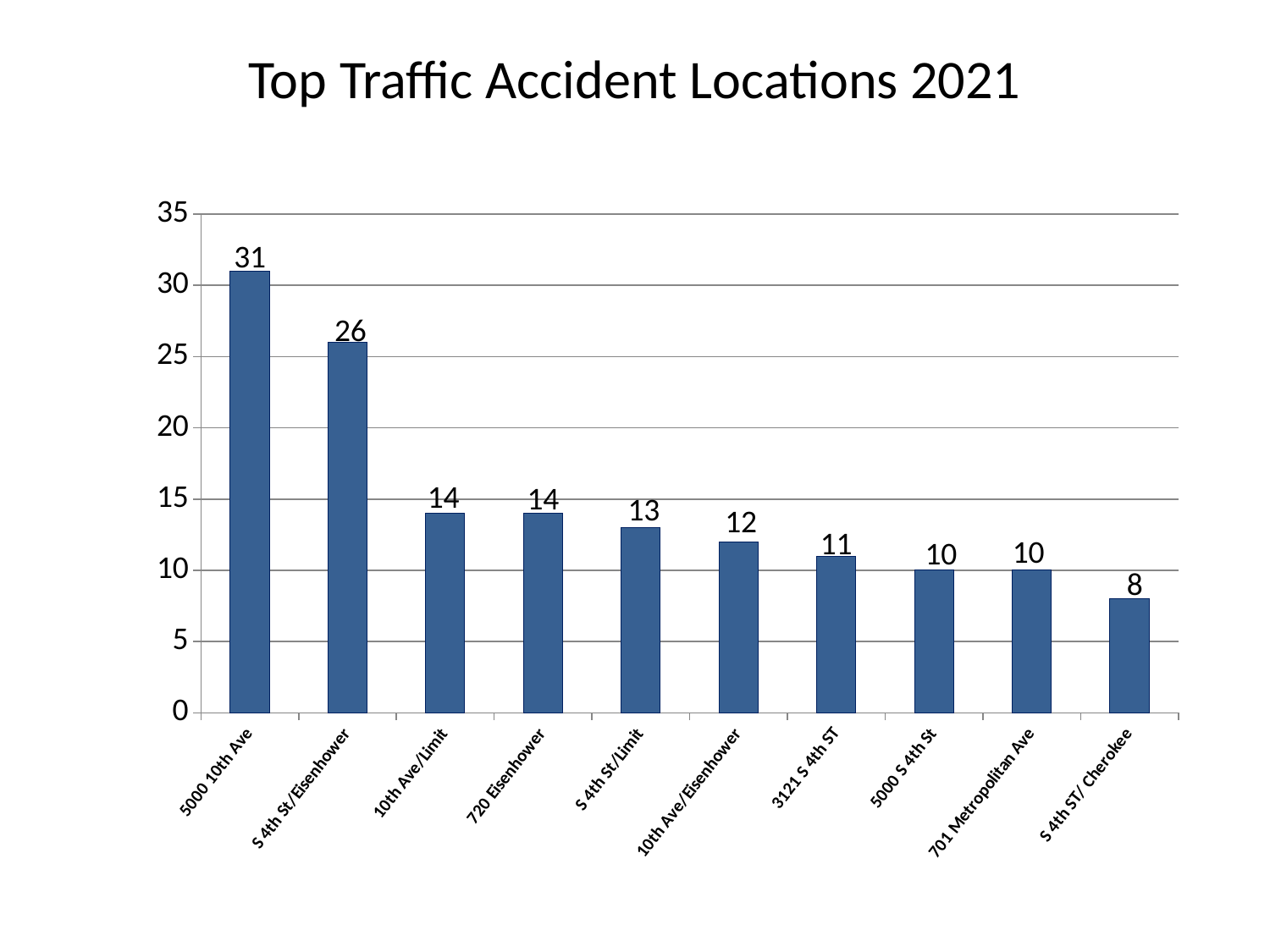
What is the difference between the values for 5000 10th Ave and S 4th St/Eisenhower? 5 What is the value for S 4th ST/ Cherokee? 8 What is the title of the chart? Top Traffic Accident Locations 2021 What is the value for S 4th St/Eisenhower? 26 What is the value for 3121 S 4th ST? 11 What is the value for 5000 10th Ave? 31 Which location has the lowest value? S 4th ST/ Cherokee What kind of chart is this? bar chart Which location has the highest value? 5000 10th Ave How many locations are shown on the chart? 10 Is the value for 720 Eisenhower greater or less than 15? less Which is larger, the value for S 4th St/Limit or the value for 10th Ave/Eisenhower? S 4th St/Limit